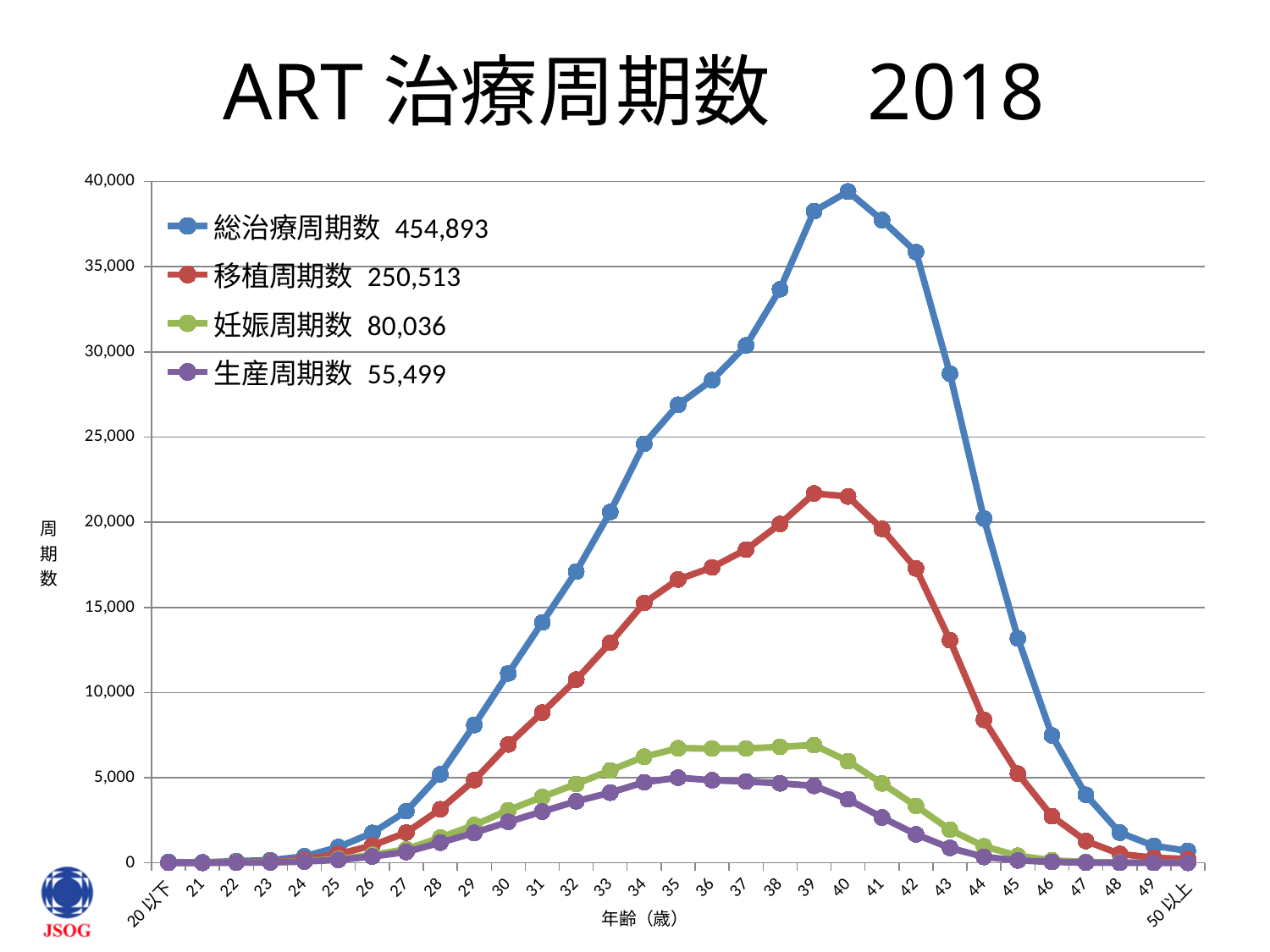
At which age does the 総治療周期数 line reach its highest value? 40 Which is larger: 総治療周期数 at age 35 or 総治療周期数 at age 45? age 35 Is the value of 生産周期数 at age 40 greater or less than 5,000? less Is the value of 移植周期数 at age 39 greater or less than 20,000? greater What total is shown in the legend for 総治療周期数? 454,893 What total is shown in the legend for 生産周期数? 55,499 How many age categories are shown on the x axis? 31 What kind of chart is shown on the slide? line chart What total is shown in the legend for 移植周期数? 250,513 How many series does the legend list? 4 Is the value of 総治療周期数 at age 40 greater or less than 35,000? greater What is the difference between the legend totals for 総治療周期数 (454,893) and 移植周期数 (250,513)? 204,380